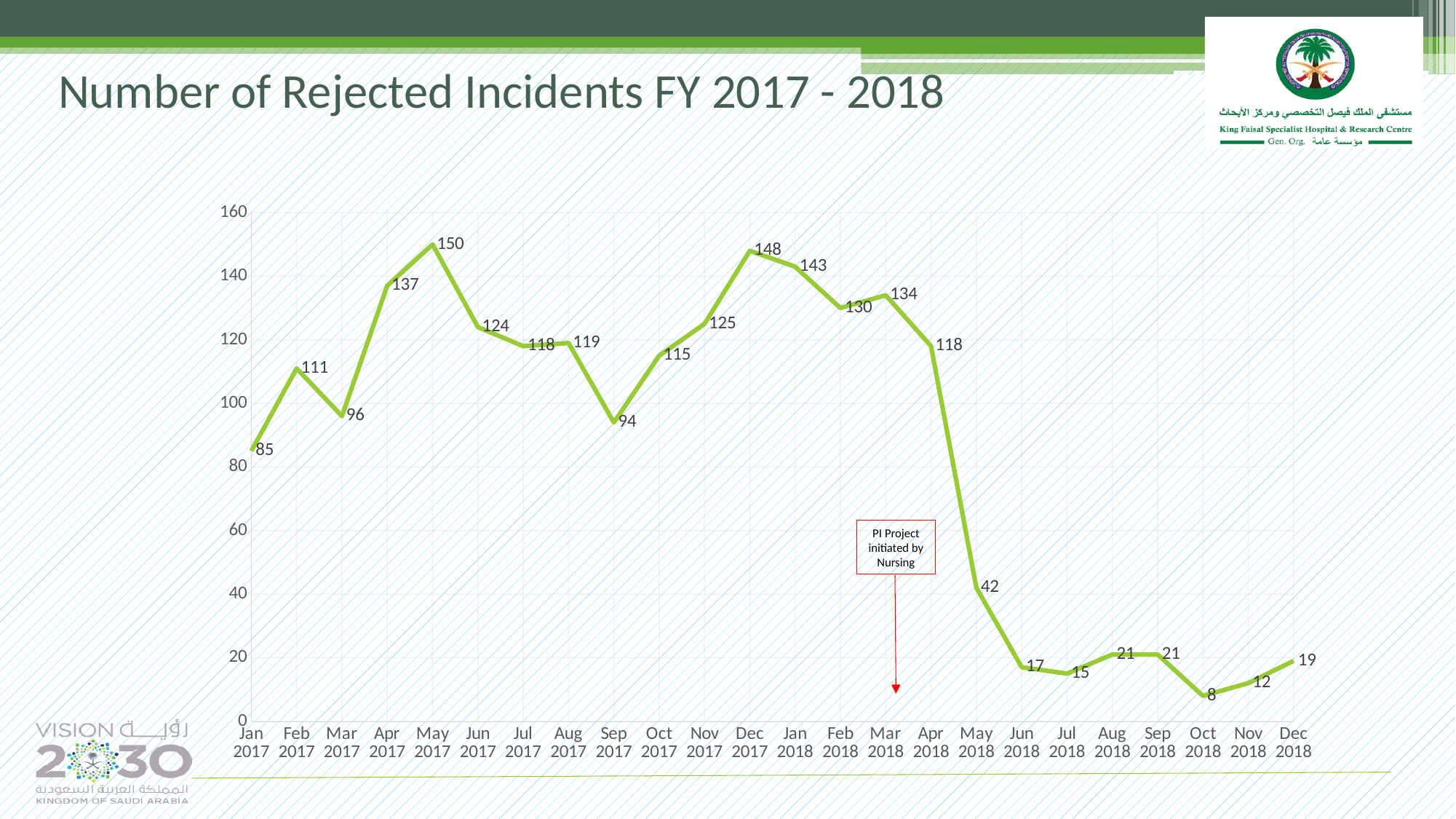
Is the value for Sep 2017 greater or less than 100? less Which month has more rejected incidents, Dec 2017 or Jan 2018? Dec 2017 What is the number of rejected incidents for May 2017? 150 What is the number of rejected incidents for Oct 2018? 8 How many months are plotted on the chart? 24 What is the number of rejected incidents for Apr 2018? 118 What is the difference between the number of rejected incidents in Apr 2018 and May 2018? 76 What is the title of the chart? Number of Rejected Incidents FY 2017 - 2018 What is the number of rejected incidents for Dec 2018? 19 What kind of chart is shown on the slide? Line chart Which month has the highest number of rejected incidents? May 2017 Which month has the lowest number of rejected incidents? Oct 2018